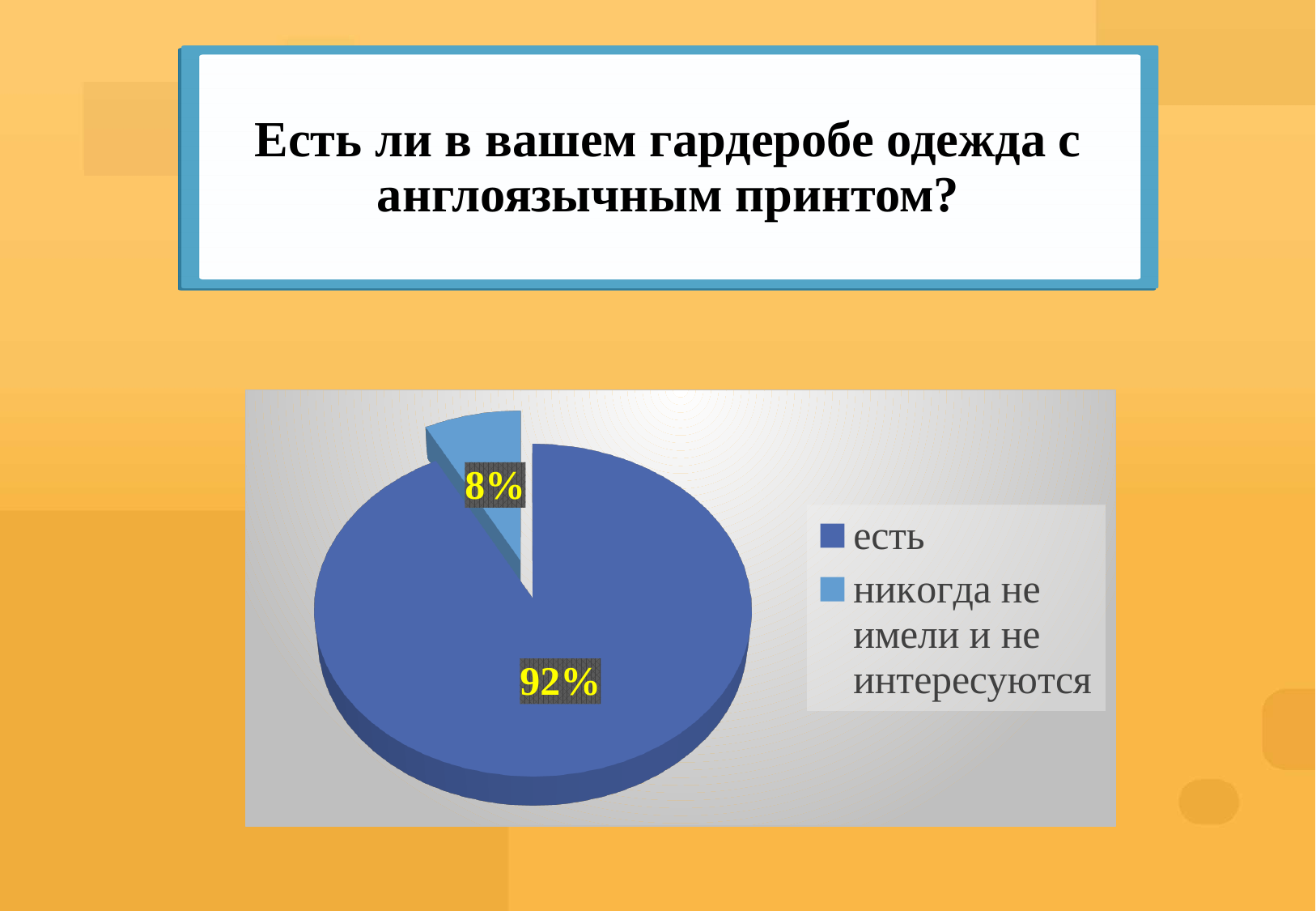
What kind of chart is shown on the slide? pie chart Which is larger: the "есть" slice or the "никогда не имели и не интересуются" slice? есть What percentage is shown for the "есть" slice? 92% What colour is the "есть" slice in the pie chart? dark blue What share of the pie does the "есть" slice take? 92% What is the difference in percentage points between the "есть" slice and the "никогда не имели и не интересуются" slice? 84 What question is written in the title box above the chart? Есть ли в вашем гардеробе одежда с англоязычным принтом? Which category has the largest share of the pie? есть Which category has the smallest share of the pie? никогда не имели и не интересуются How many slices does the pie chart have? 2 What percentage is shown for the "никогда не имели и не интересуются" slice? 8% How many entries does the legend list? 2